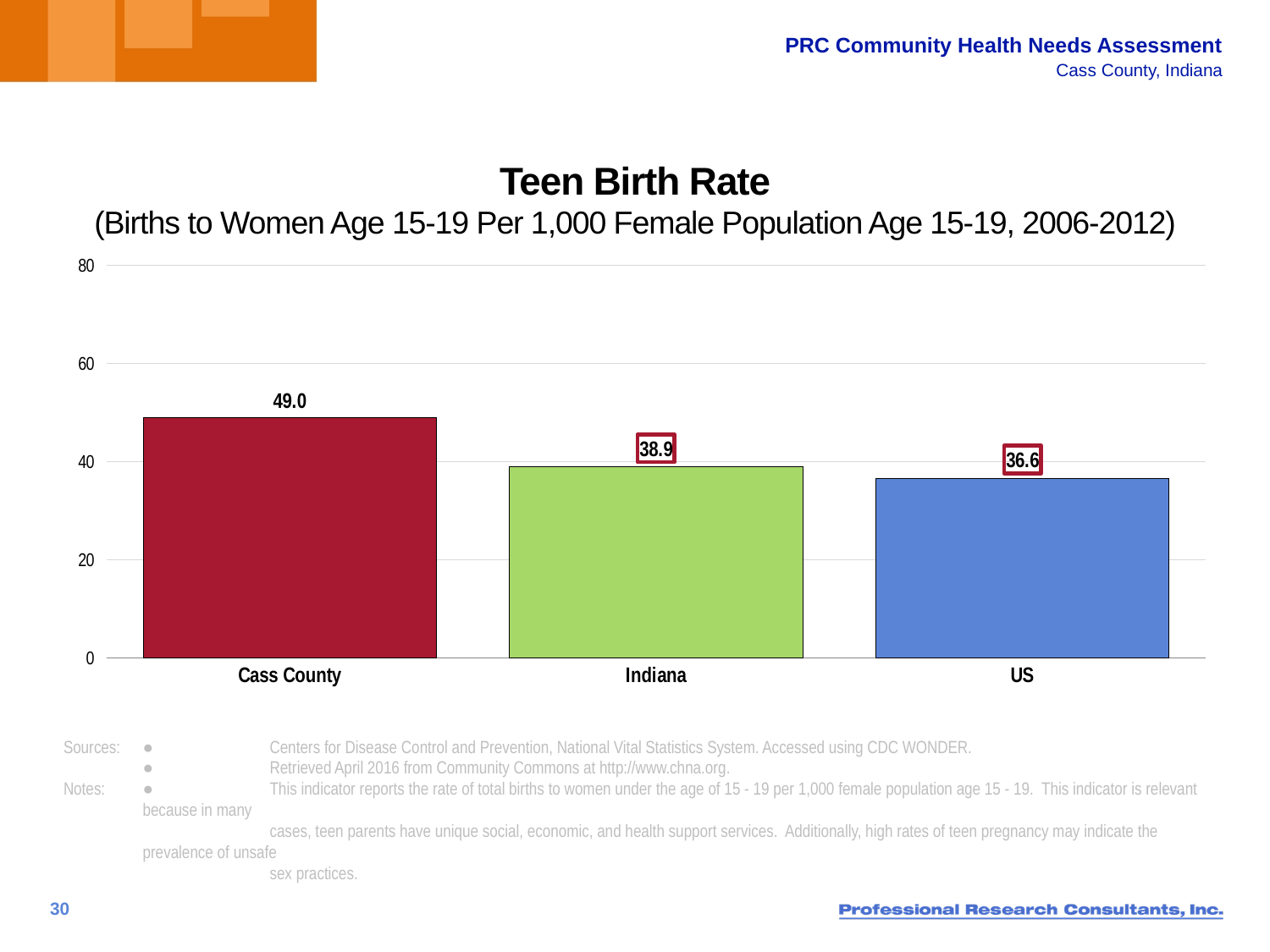
What is the teen birth rate for Cass County? 49.0 Is the value for Cass County greater or less than 40? greater What is the title of the chart? Teen Birth Rate Which category has the lowest teen birth rate? US What is the teen birth rate for the US? 36.6 What kind of chart is shown on the slide? bar chart Which category has the highest teen birth rate? Cass County How many categories are shown in the chart? 3 What is the difference between the teen birth rate for Cass County and the US? 12.4 What is the teen birth rate for Indiana? 38.9 Which has a higher teen birth rate, Cass County or Indiana? Cass County What is the difference between the teen birth rate for Indiana and the US? 2.3